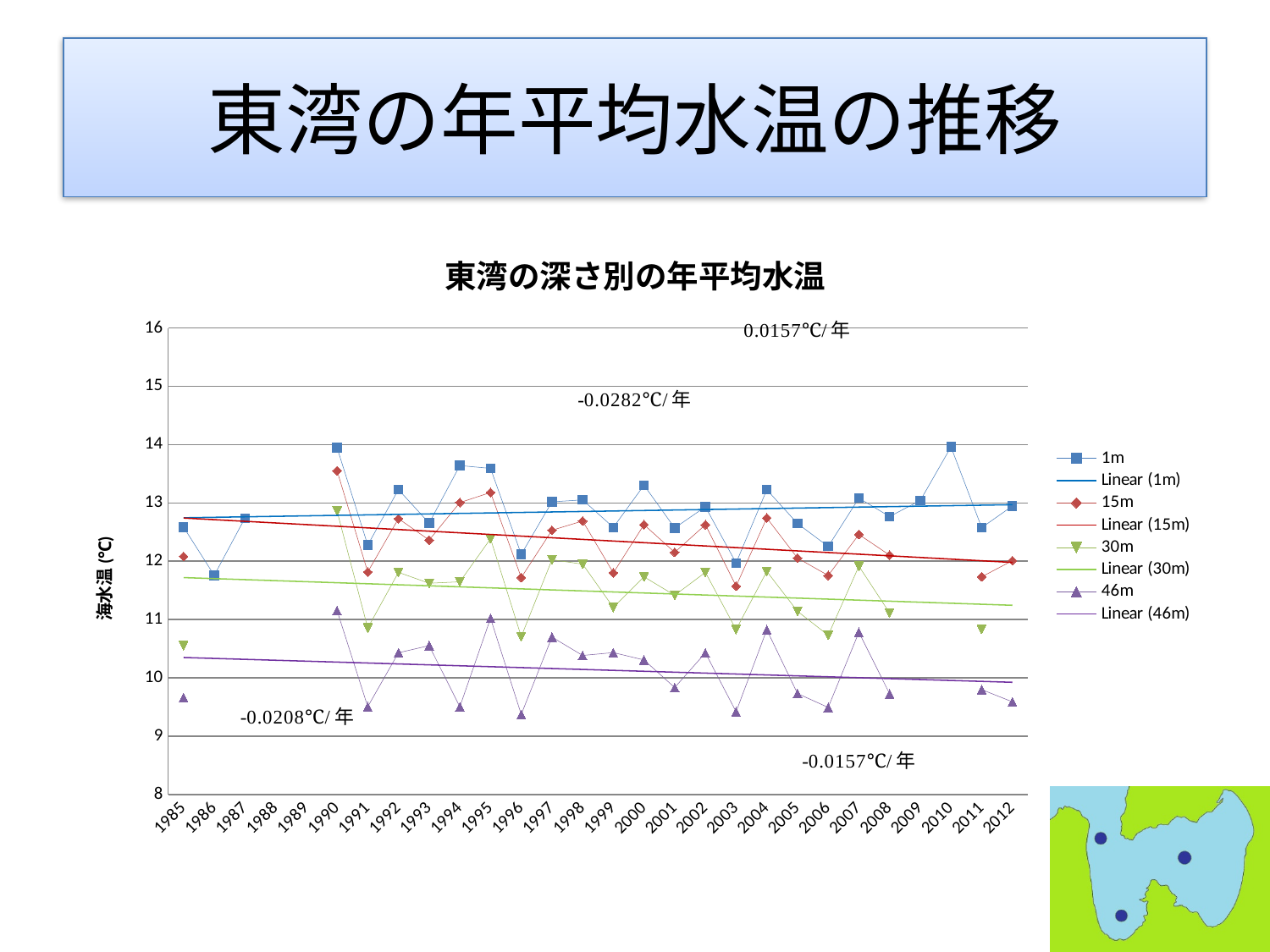
What kind of chart is shown on the slide? line chart Is the value for the 30m series in 2006 greater or less than 11? less How many entries does the chart legend list? 8 Is the value for the 15m series in 1990 greater or less than 13? greater Which depth series has the lowest values across the chart? 46m Is the value for the 1m series in 1990 greater or less than 13? greater What is the title of the chart? 東湾の深さ別の年平均水温 In 1990, which is higher: the 1m series or the 46m series? 1m Does the Linear (1m) trend line rise or fall from 1985 to 2012? rises How many years are labelled along the x axis? 28 What is the label of the vertical axis? 海水温 (℃)